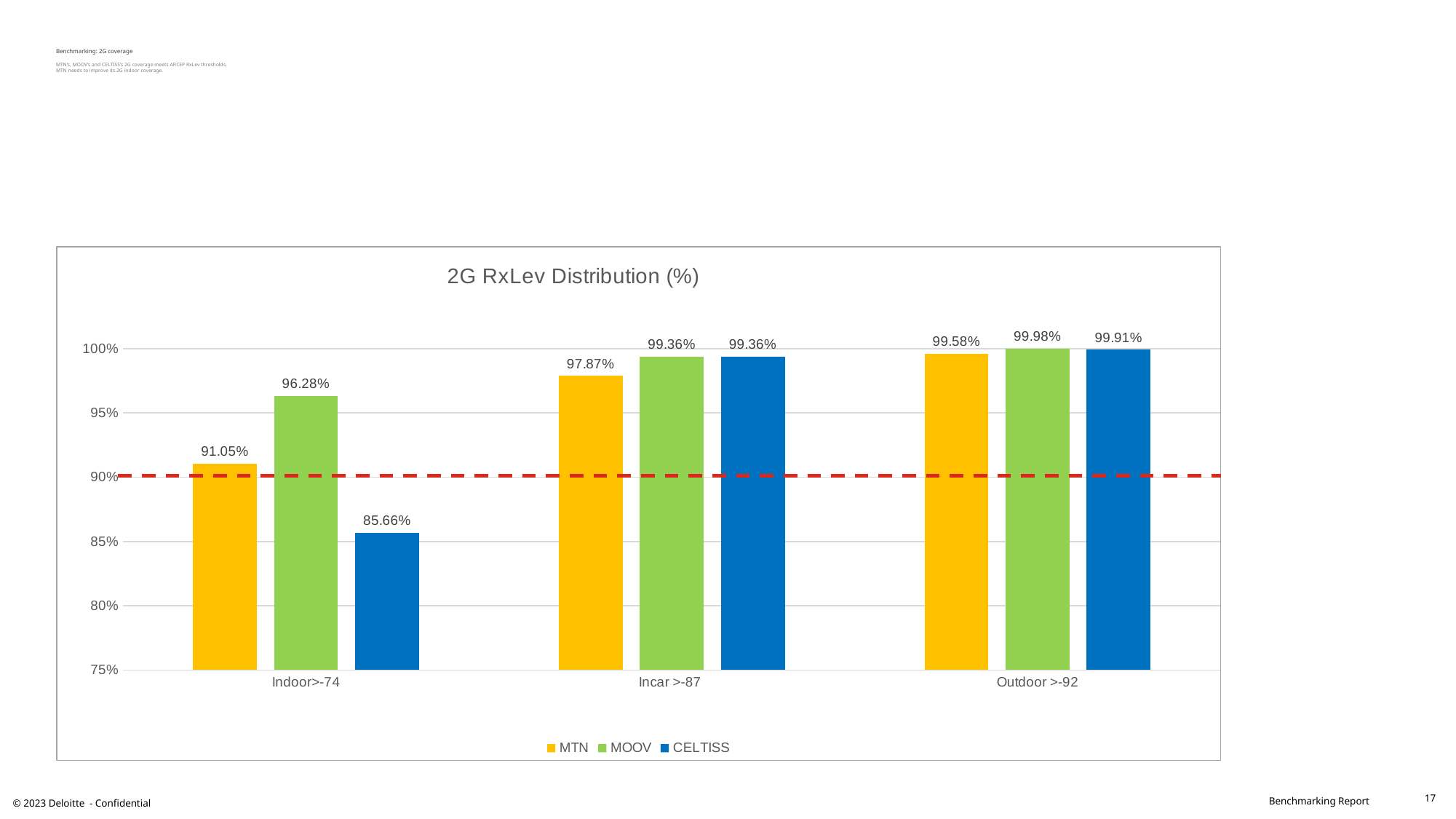
Is the value for CELTISS in the Indoor>-74 category greater or less than 90%? less What is the value for MTN in the Incar >-87 category? 97.87% How many series does the legend list? 3 What is the value for MTN in the Indoor>-74 category? 91.05% What type of chart is shown on the slide? bar chart What is the difference between MOOV and MTN in the Indoor>-74 category? 5.23% What is the value for CELTISS in the Indoor>-74 category? 85.66% Which series has the lowest value in the Indoor>-74 category? CELTISS Which is larger for MTN: the Incar >-87 value or the Outdoor >-92 value? Outdoor >-92 How many categories are shown on the x axis? 3 Which series has the highest value in the Indoor>-74 category? MOOV What is the value for MOOV in the Outdoor >-92 category? 99.98%